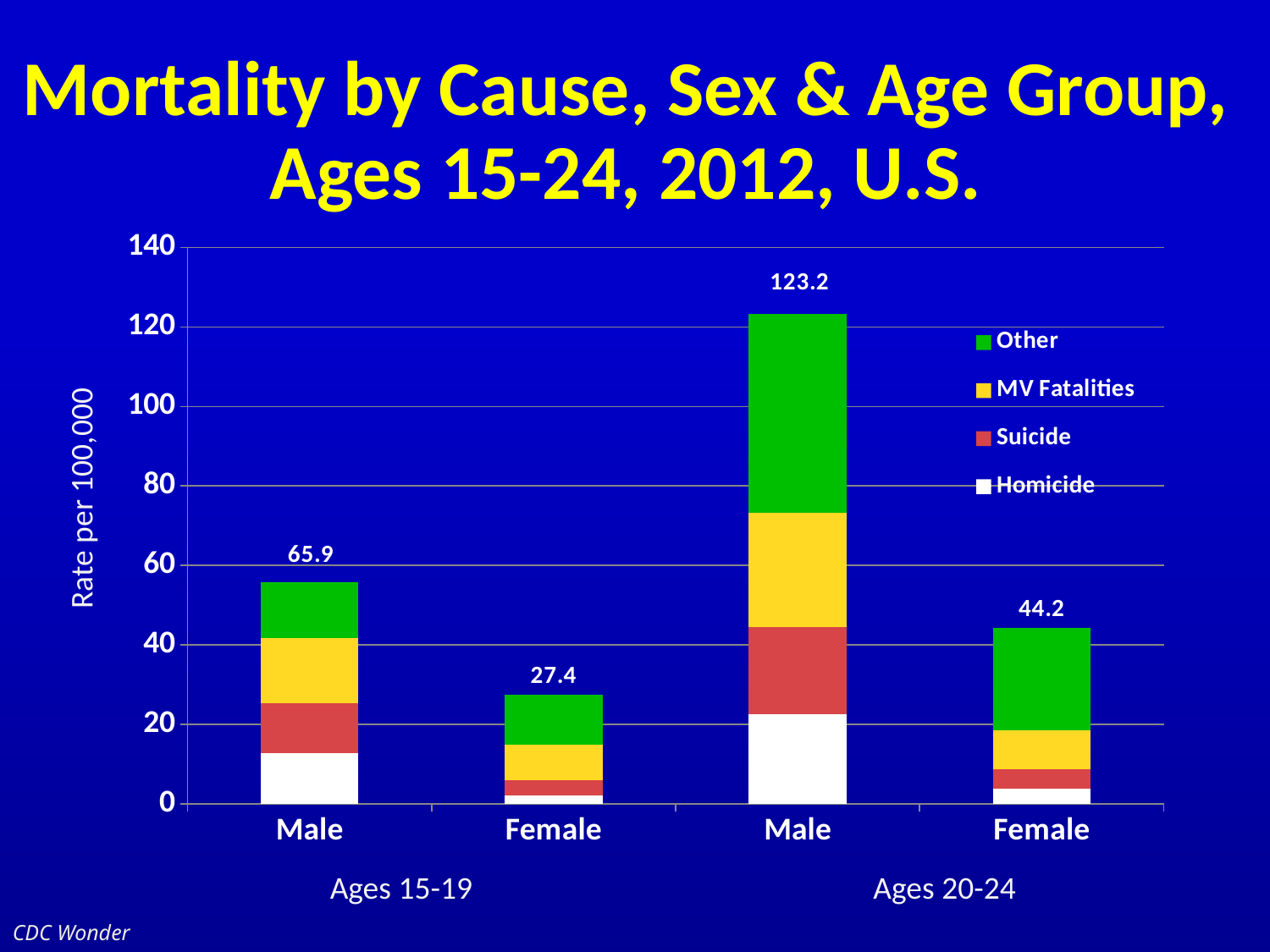
What is the difference between the total rate for females aged 20-24 and females aged 15-19? 16.8 What kind of chart is shown on the slide? Stacked bar chart What is the total mortality rate labelled for females aged 15-19? 27.4 How many bars are plotted in the chart? 4 How many series does the legend list? 4 Which sex and age group has the lowest total mortality rate? Female, Ages 15-19 What is the difference between the total rate for males aged 20-24 and males aged 15-19? 57.3 What is the total mortality rate labelled for males aged 20-24? 123.2 What is the total mortality rate labelled for females aged 20-24? 44.2 Is the total rate for males aged 20-24 greater or less than 100? greater Which sex and age group has the highest total mortality rate? Male, Ages 20-24 Which is larger, the total rate for males aged 15-19 or females aged 20-24? Males aged 15-19